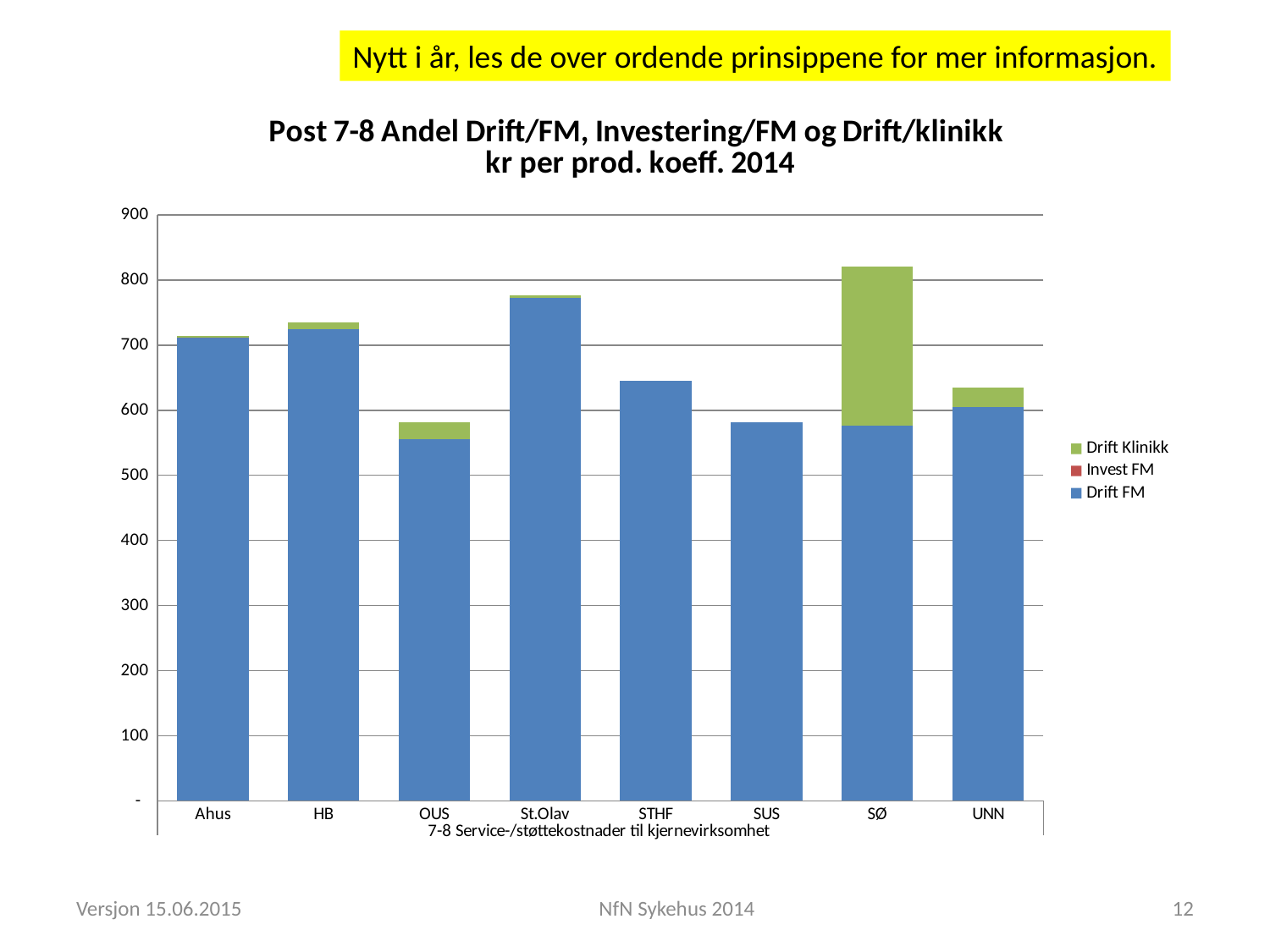
Is the total value for SØ greater or less than 800? greater Which hospital has the highest total bar? SØ Which has the larger total bar, St.Olav or SØ? SØ Is the total value for STHF greater or less than 600? greater Is the total value for OUS greater or less than 600? less Which hospital has the largest Drift Klinikk segment? SØ What is the label shown below the category names on the x axis? 7-8 Service-/støttekostnader til kjernevirksomhet Which hospital has the tallest Drift FM segment? St.Olav What kind of chart is shown on the slide? Stacked bar chart Which has the larger total bar, HB or STHF? HB How many hospitals (categories) are shown on the x axis? 8 How many series does the legend list? 3